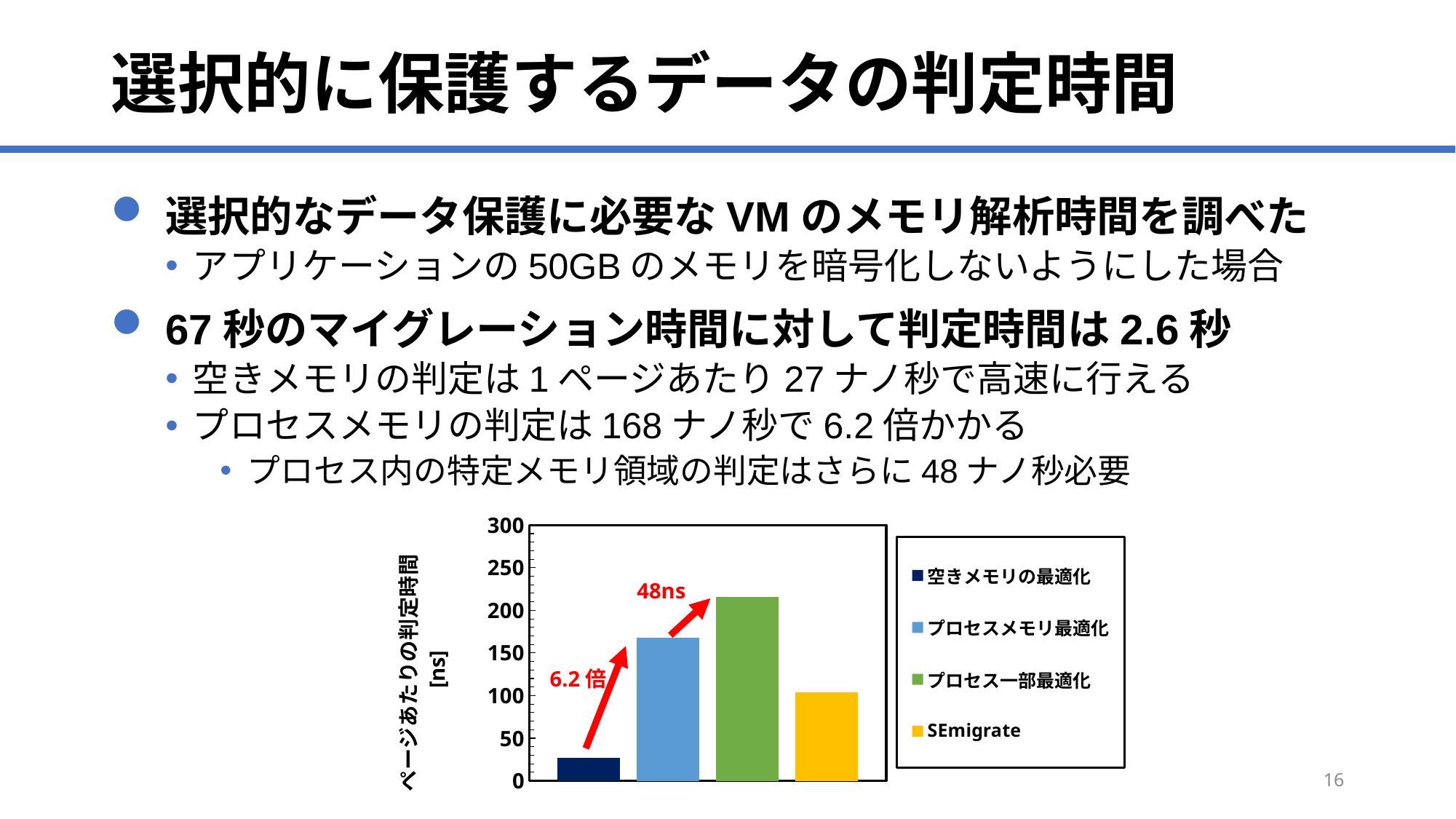
Is the value for プロセスメモリ最適化 greater or less than 150? greater How many series does the chart legend list? 4 Which is larger, the value for SEmigrate or the value for プロセスメモリ最適化? プロセスメモリ最適化 Is the value for プロセス一部最適化 greater or less than 200? greater What is the label of the vertical axis of the chart? ページあたりの判定時間 [ns] Which series has the highest bar in the chart? プロセス一部最適化 Is the value for 空きメモリの最適化 greater or less than 50? less What does the red annotation between the プロセスメモリ最適化 bar and the プロセス一部最適化 bar say? 48ns How many bars are plotted in the chart? 4 Which series has the lowest bar in the chart? 空きメモリの最適化 What kind of chart is shown on the slide? bar chart